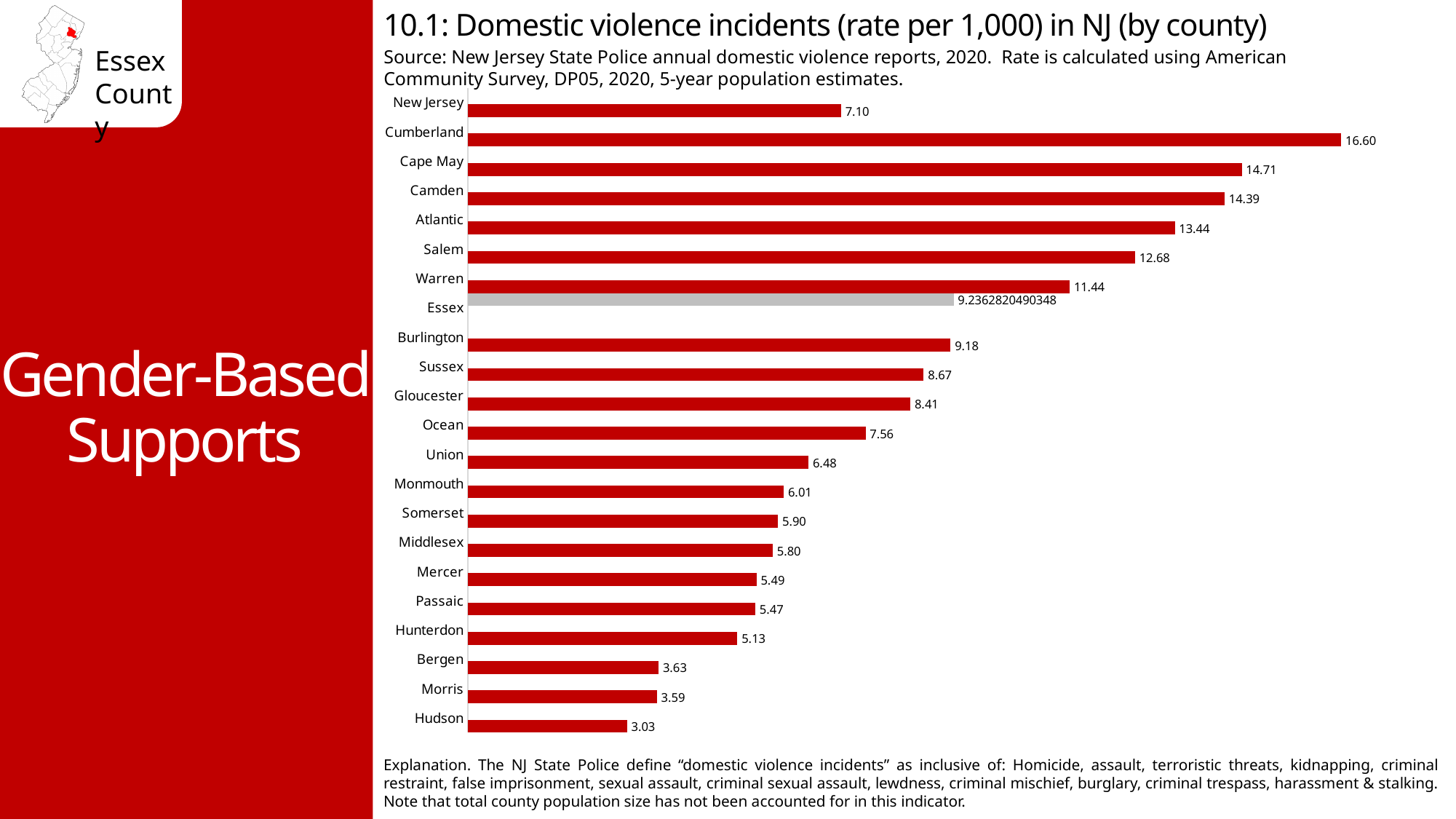
Which has a higher rate, Cape May or Camden? Cape May What value is shown for Essex? 9.2362820490348 What is the domestic violence incident rate for Hudson? 3.03 Which bar is coloured grey instead of red? Essex What is the rate shown for New Jersey overall? 7.10 Which county has the highest domestic violence incident rate? Cumberland How many bars are plotted in the chart? 22 Which county has the lowest domestic violence incident rate? Hudson What is the domestic violence incident rate for Cumberland? 16.60 What type of chart is shown on the slide? Bar chart What is the difference between the rates for Salem and Warren? 1.24 What is the difference between the rates for Cumberland and Hudson? 13.57